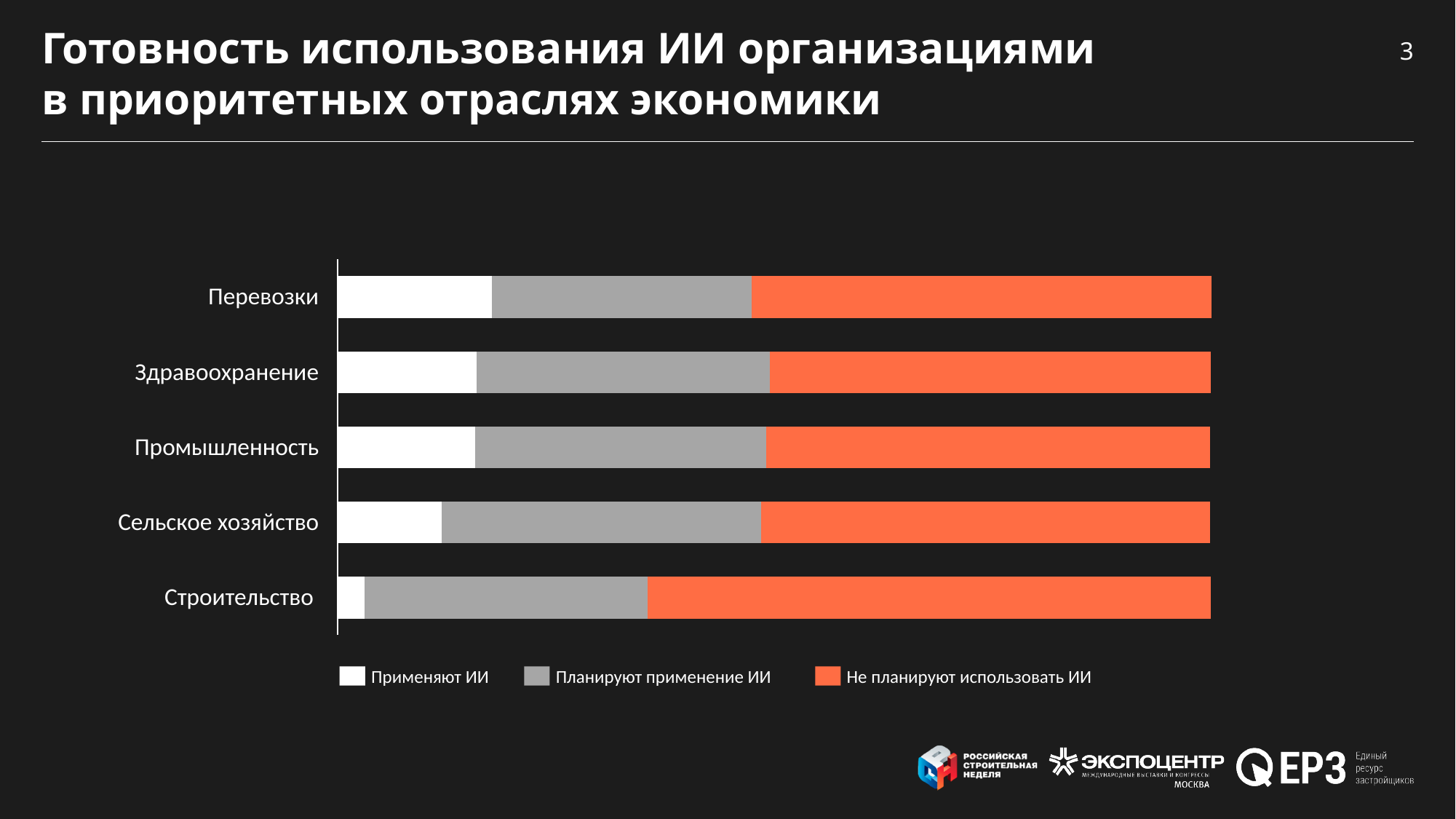
Is the "Не планируют использовать ИИ" segment larger for Строительство or for Перевозки? Строительство Which category has the smallest "Применяют ИИ" segment? Строительство Which series is shown in orange in the legend? Не планируют использовать ИИ Is the "Применяют ИИ" segment larger for Перевозки or for Строительство? Перевозки How many series does the legend list? 3 Which category has the largest "Не планируют использовать ИИ" segment? Строительство What kind of chart is shown on the slide? Stacked bar chart Which category is listed at the top of the chart? Перевозки Is the "Применяют ИИ" segment larger for Сельское хозяйство or for Строительство? Сельское хозяйство How many industry categories are shown on the chart? 5